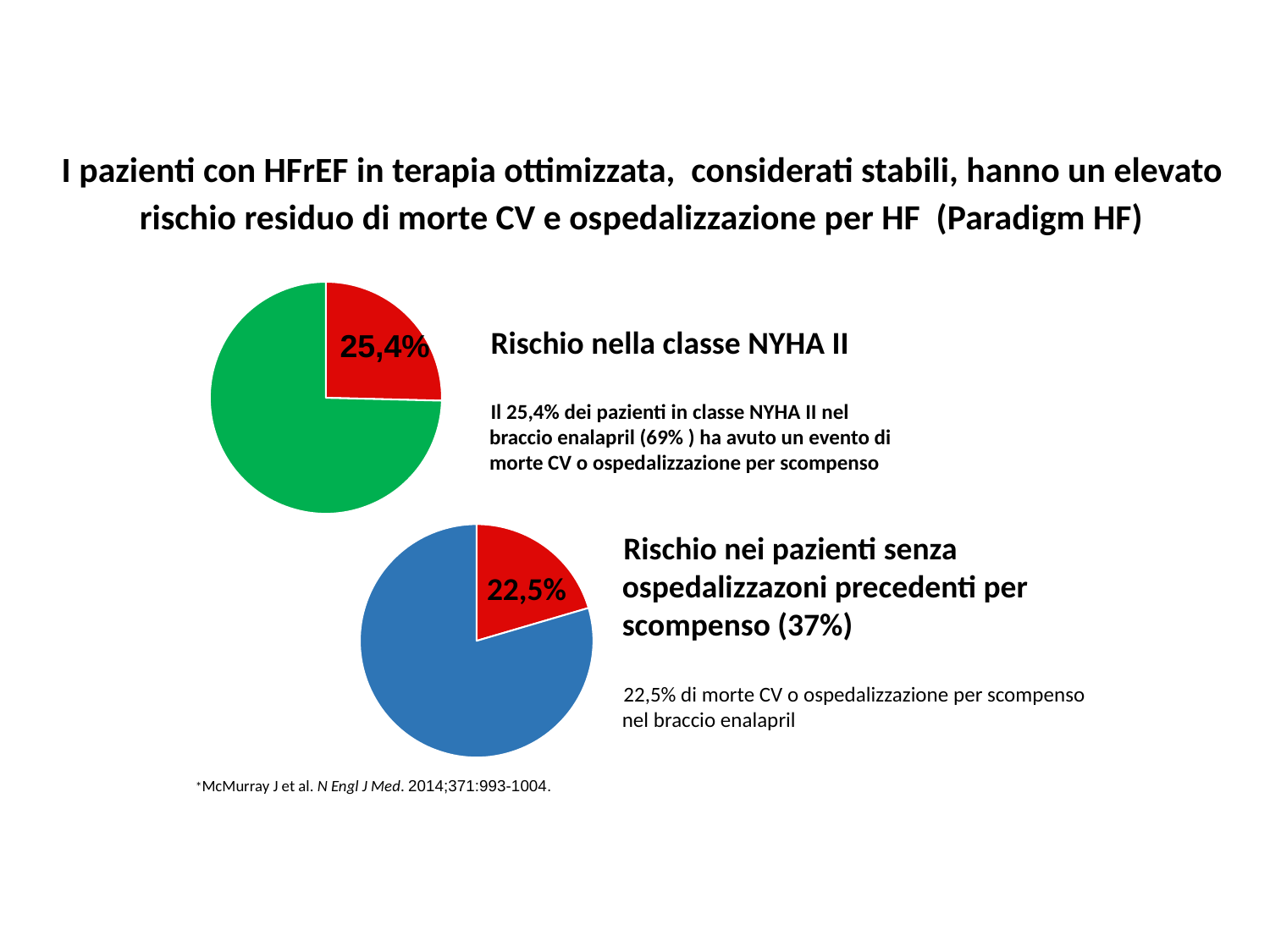
How many slices does the top pie chart have? 2 In the bottom pie chart (Rischio nei pazienti senza ospedalizzazoni precedenti per scompenso), what value is shown on the red slice? 22,5% What colour is the larger slice in the top pie chart? Green How many slices does the bottom pie chart have? 2 What colour is the larger slice in the bottom pie chart? Blue What kind of chart is the top chart on the slide? Pie chart In the top pie chart (Rischio nella classe NYHA II), what value is shown on the red slice? 25,4% What kind of chart is the bottom chart on the slide? Pie chart Which red slice is larger: the one in the top pie chart or the one in the bottom pie chart? The top pie chart (25,4%) In the bottom pie chart, which slice is larger, the blue one or the red one? The blue one In the top pie chart, which slice is larger, the green one or the red one? The green one What is the difference between the red slice value in the top pie chart and the red slice value in the bottom pie chart? 2,9%